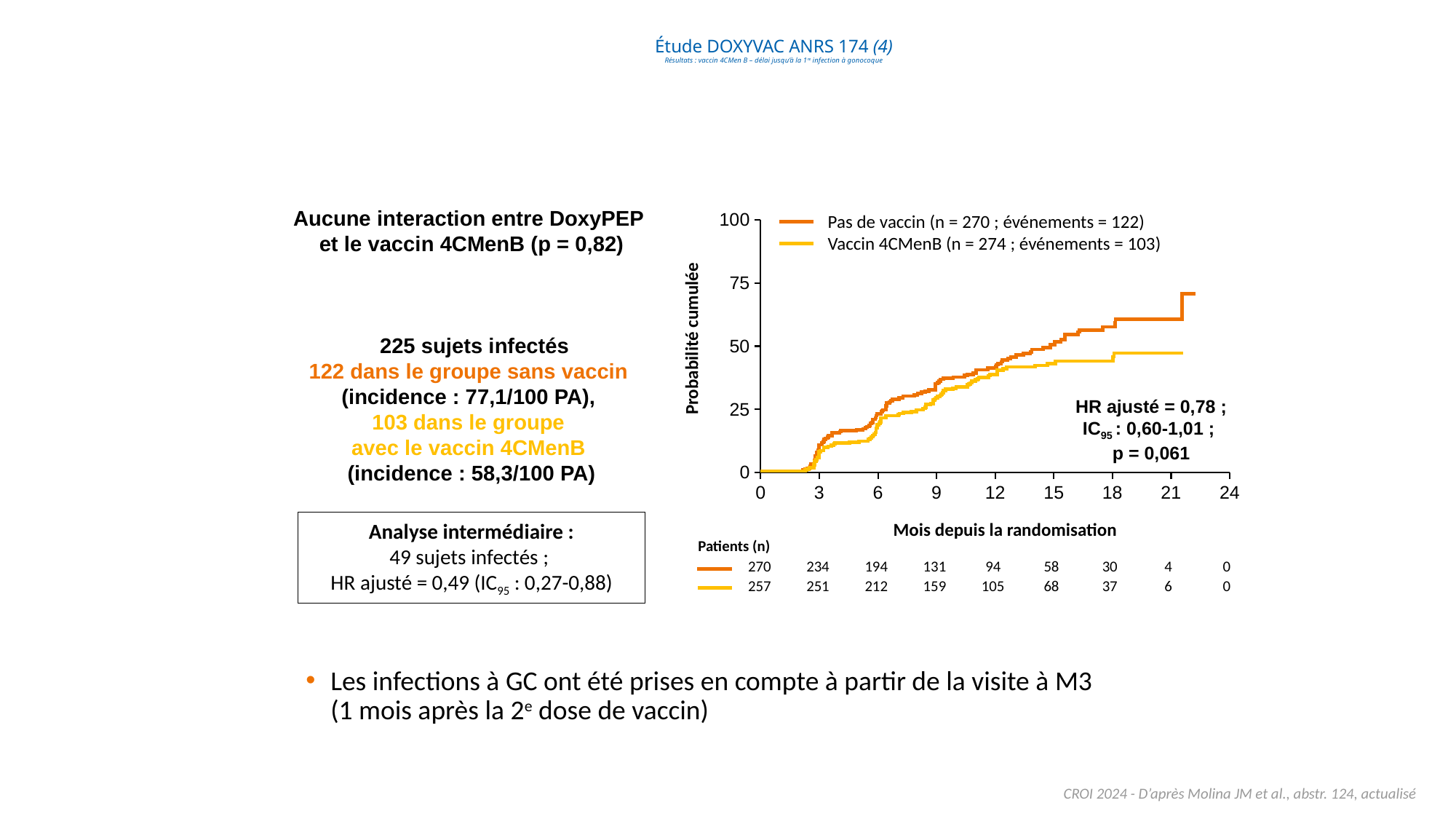
Is the cumulative probability for 'Vaccin 4CMenB' at 12 months greater or less than 50? less Is the cumulative probability for 'Pas de vaccin' at 18 months greater or less than 50? greater What is the label of the y axis of the chart? Probabilité cumulée What is the label of the x axis of the chart? Mois depuis la randomisation In the 'Patients (n)' table, what is the difference between the number of patients at risk at month 0 in the 'Pas de vaccin' group (270) and in the 'Vaccin 4CMenB' group (257)? 13 According to the legend, how many events were recorded in the 'Pas de vaccin' group? 122 In the 'Patients (n)' table below the chart, how many patients are at risk in the 'Pas de vaccin' group at 9 months? 131 How many series does the chart legend list? 2 According to the legend, what is n for the 'Vaccin 4CMenB' group? 274 What kind of chart is shown on the slide? line chart At 15 months, which curve is higher, 'Pas de vaccin' or 'Vaccin 4CMenB'? Pas de vaccin Do the curves rise or fall as months since randomisation increase? rise